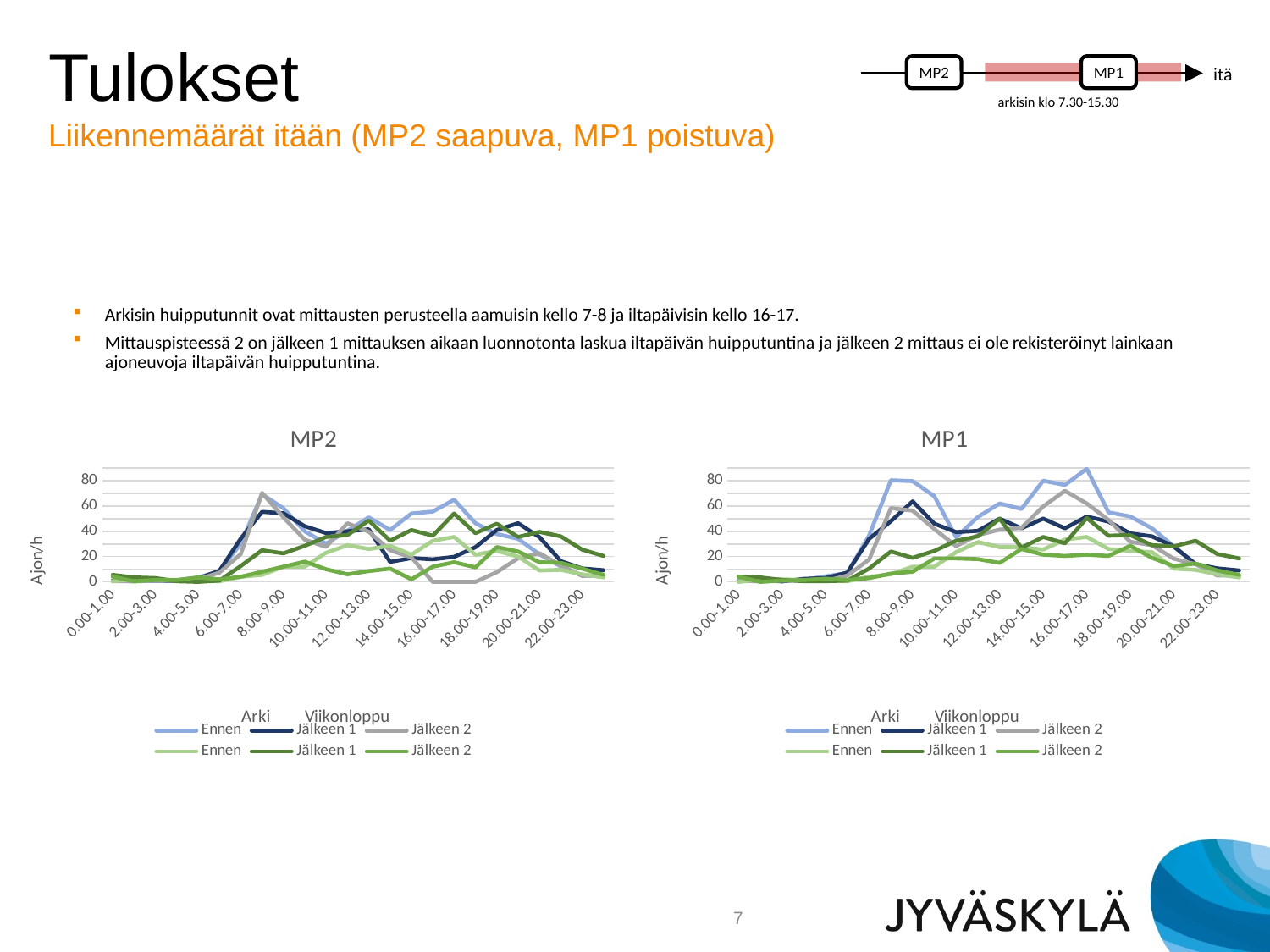
In the MP1 chart, does the Arki Ennen series rise or fall between 4.00-5.00 and 7.00-8.00? rise In the MP1 chart, is the value of the Viikonloppu Ennen series at 0.00-1.00 greater or less than 20? less In the MP2 chart, is the value of the Arki Jälkeen 2 series at 7.00-8.00 greater or less than 60? greater How many series does the legend of the MP1 chart list? 6 What are the two group headings in the legend of the MP2 chart? Arki and Viikonloppu In the MP2 chart, is the value of the Arki Jälkeen 2 series at 16.00-17.00 greater or less than 20? less What kind of chart is the MP2 chart? line chart In the MP1 chart at 16.00-17.00, which is larger: Arki Ennen or Arki Jälkeen 1? Arki Ennen How many time-interval labels are shown on the x axis of the MP2 chart? 12 What is the y-axis label on the MP2 chart? Ajon/h In the MP1 chart, which series reaches the highest value overall? Arki Ennen